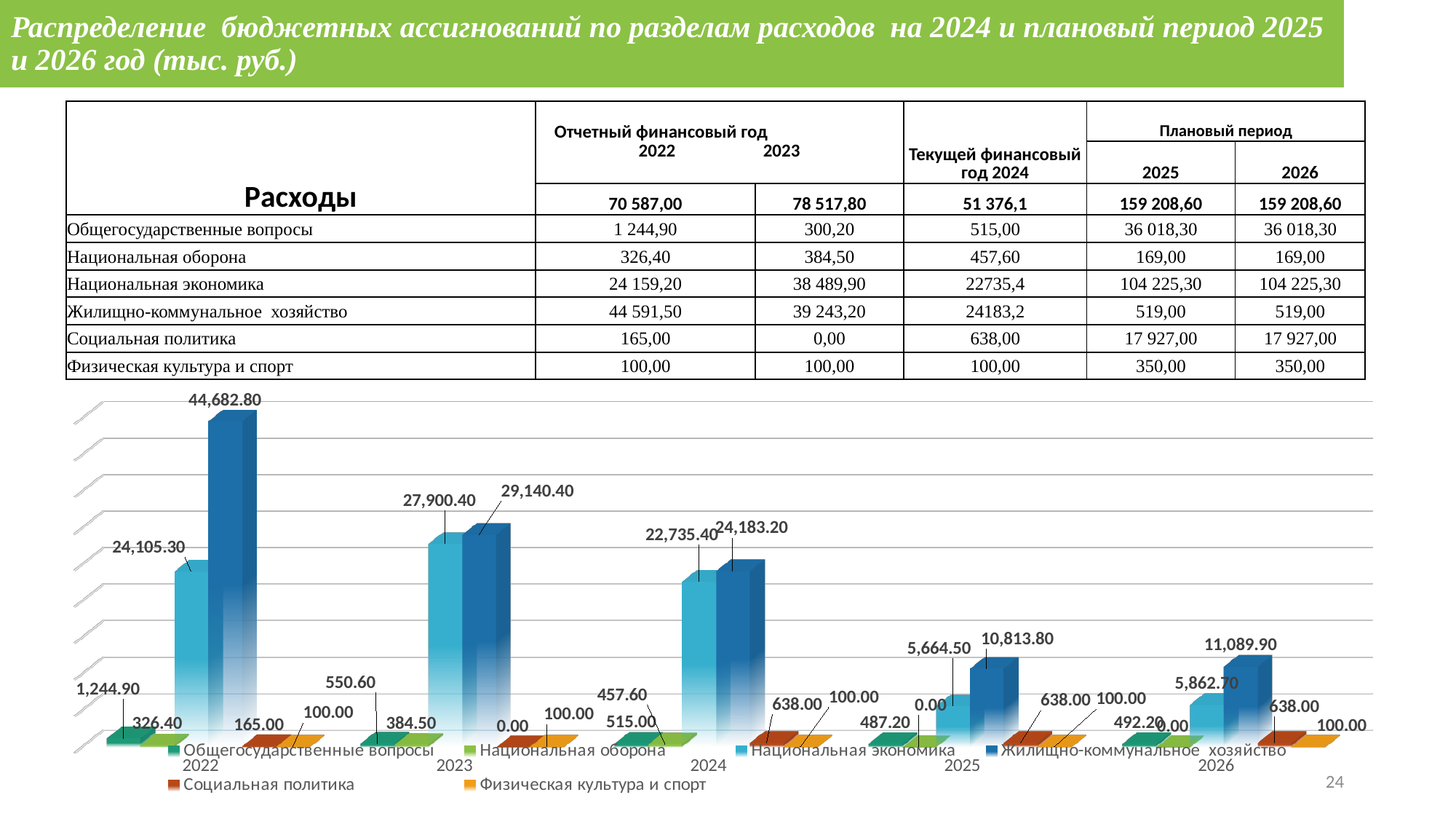
How many year categories are shown along the x axis of the chart? 5 Which year has the highest bar for Жилищно-коммунальное хозяйство in the chart? 2022 In the chart, what is the value for Национальная экономика in 2024? 22,735.40 In the chart, what is the value for Жилищно-коммунальное хозяйство in 2022? 44,682.80 In the chart, which series has the lowest value in 2024? Физическая культура и спорт In the chart, what is the difference between Жилищно-коммунальное хозяйство and Национальная экономика in 2022? 20,577.50 In the chart, what is the value for Социальная политика in 2023? 0.00 What kind of chart is shown below the table on the slide? bar chart In the chart, do the values for Жилищно-коммунальное хозяйство rise or fall from 2022 to 2025? fall In the chart, what is the value for Жилищно-коммунальное хозяйство in 2026? 11,089.90 In the chart, which is larger in 2023: Национальная экономика or Жилищно-коммунальное хозяйство? Жилищно-коммунальное хозяйство How many series does the chart legend list? 6